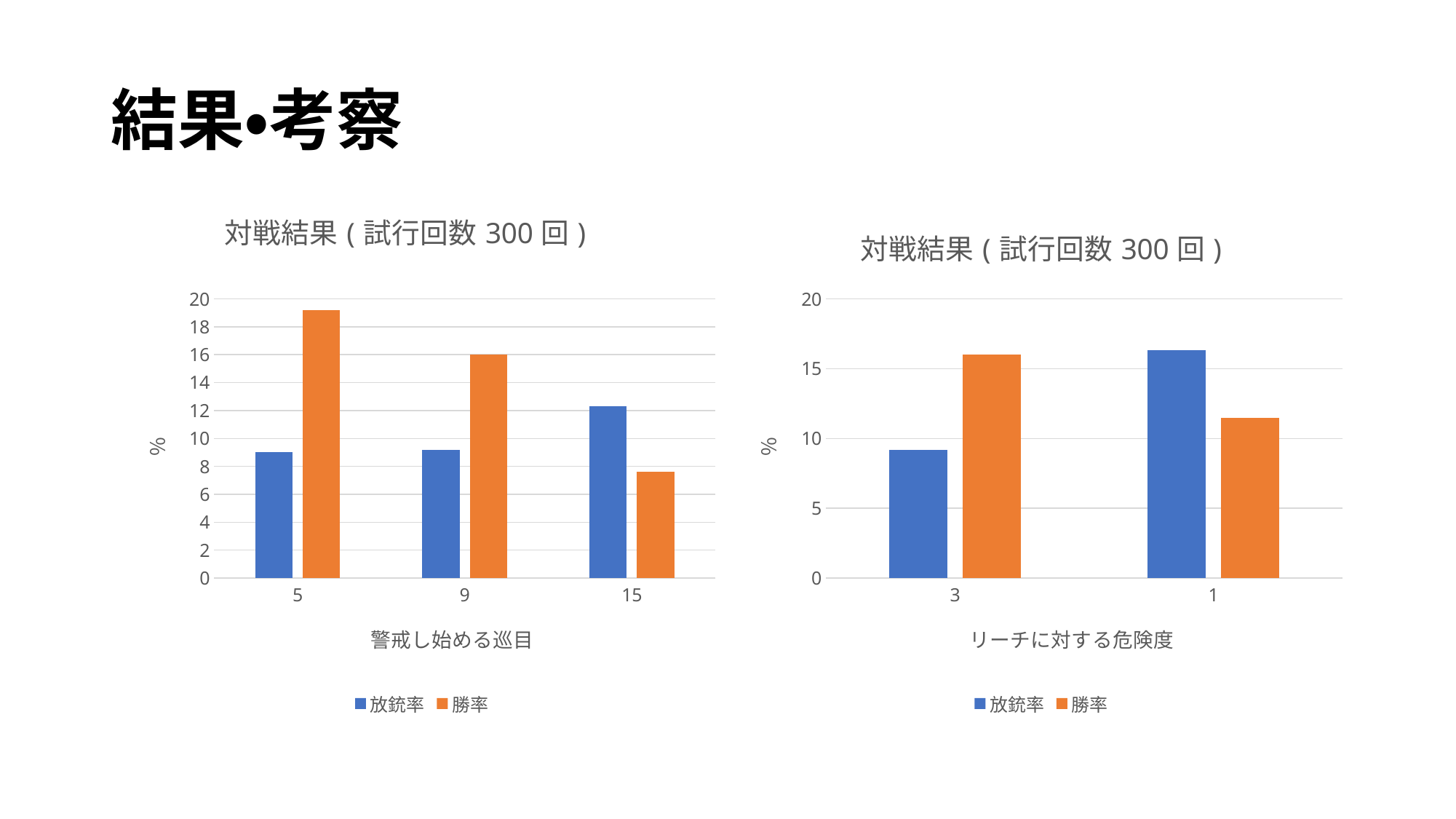
In the right chart (x axis リーチに対する危険度), is the 放銃率 for category 1 greater or less than 15? greater In the left chart (x axis 警戒し始める巡目), which category has the highest 勝率? 5 In the right chart (x axis リーチに対する危険度), for category 3, which is larger: 放銃率 or 勝率? 勝率 In the left chart (x axis 警戒し始める巡目), for category 15, which is larger: 放銃率 or 勝率? 放銃率 In the left chart (x axis 警戒し始める巡目), which category has the highest 放銃率? 15 How many categories are shown on the x axis of the left chart (x axis 警戒し始める巡目)? 3 How many categories are shown on the x axis of the right chart (x axis リーチに対する危険度)? 2 In the left chart (x axis 警戒し始める巡目), which category has the lowest 勝率? 15 In the left chart (x axis 警戒し始める巡目), is the 勝率 for category 5 greater or less than 18? greater In the left chart (x axis 警戒し始める巡目), does the 勝率 rise or fall as the category moves from 5 to 15? fall What kind of chart is the left chart (x axis 警戒し始める巡目)? bar chart How many series does the legend of the left chart (x axis 警戒し始める巡目) list? 2